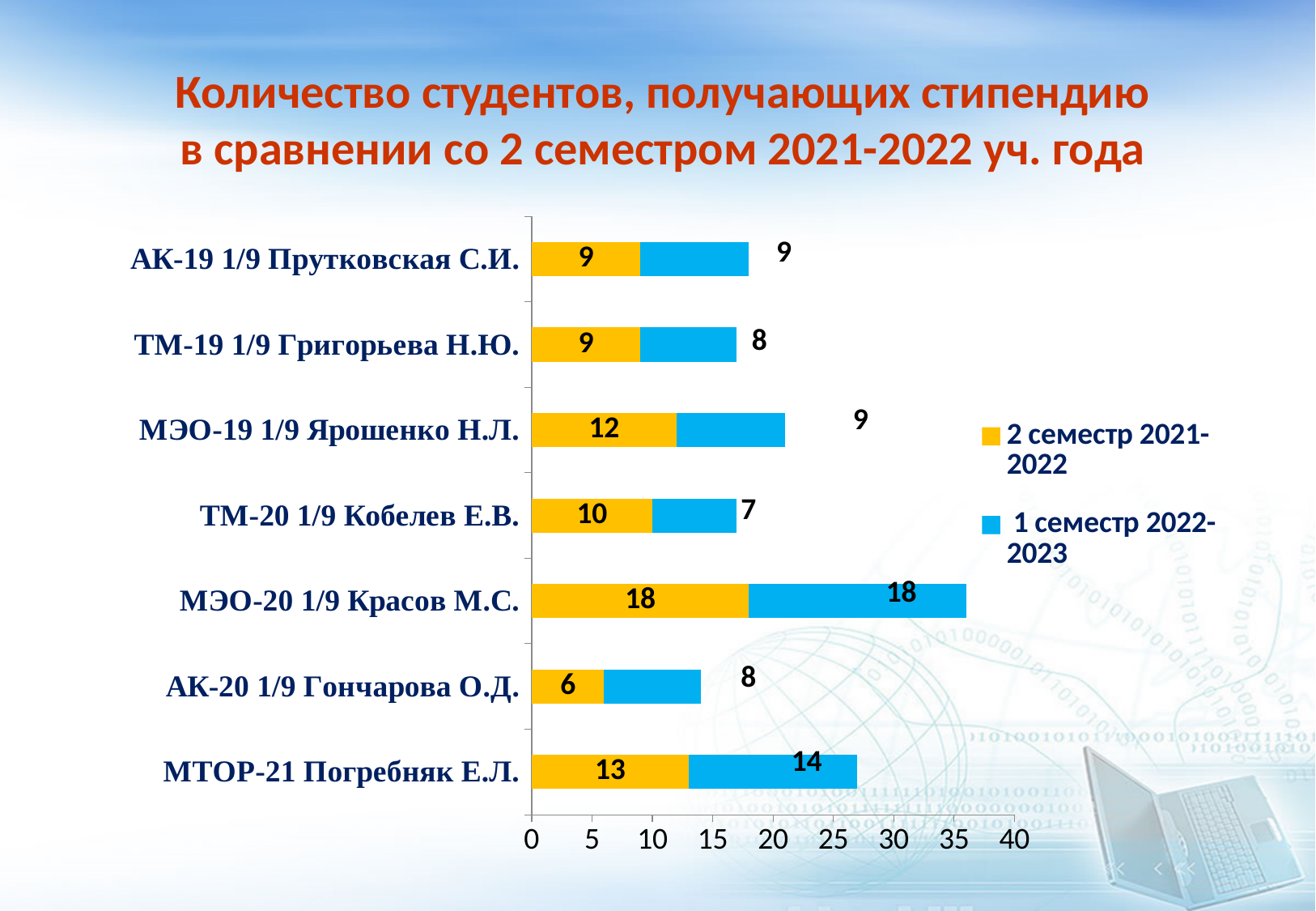
What is the total of the stacked bar for МЭО-20 1/9 Красов М.С.? 36 How many series does the legend list? 2 Which colour represents the series "2 семестр 2021-2022" in the legend? Yellow (orange) What type of chart is shown on the slide? Stacked bar chart What is the value for МЭО-19 1/9 Ярошенко Н.Л. in the series "2 семестр 2021-2022"? 12 Which group has the lowest value in the series "1 семестр 2022-2023"? ТМ-20 1/9 Кобелев Е.В. How many groups (categories) are plotted on the chart? 7 What is the value for МТОР-21 Погребняк Е.Л. in the series "1 семестр 2022-2023"? 14 For АК-20 1/9 Гончарова О.Д., which series has the larger value: "2 семестр 2021-2022" or "1 семестр 2022-2023"? 1 семестр 2022-2023 What is the difference between the "2 семестр 2021-2022" and "1 семестр 2022-2023" values for ТМ-20 1/9 Кобелев Е.В.? 3 What is the value for АК-20 1/9 Гончарова О.Д. in the series "2 семестр 2021-2022"? 6 Which group has the highest value in the series "2 семестр 2021-2022"? МЭО-20 1/9 Красов М.С.